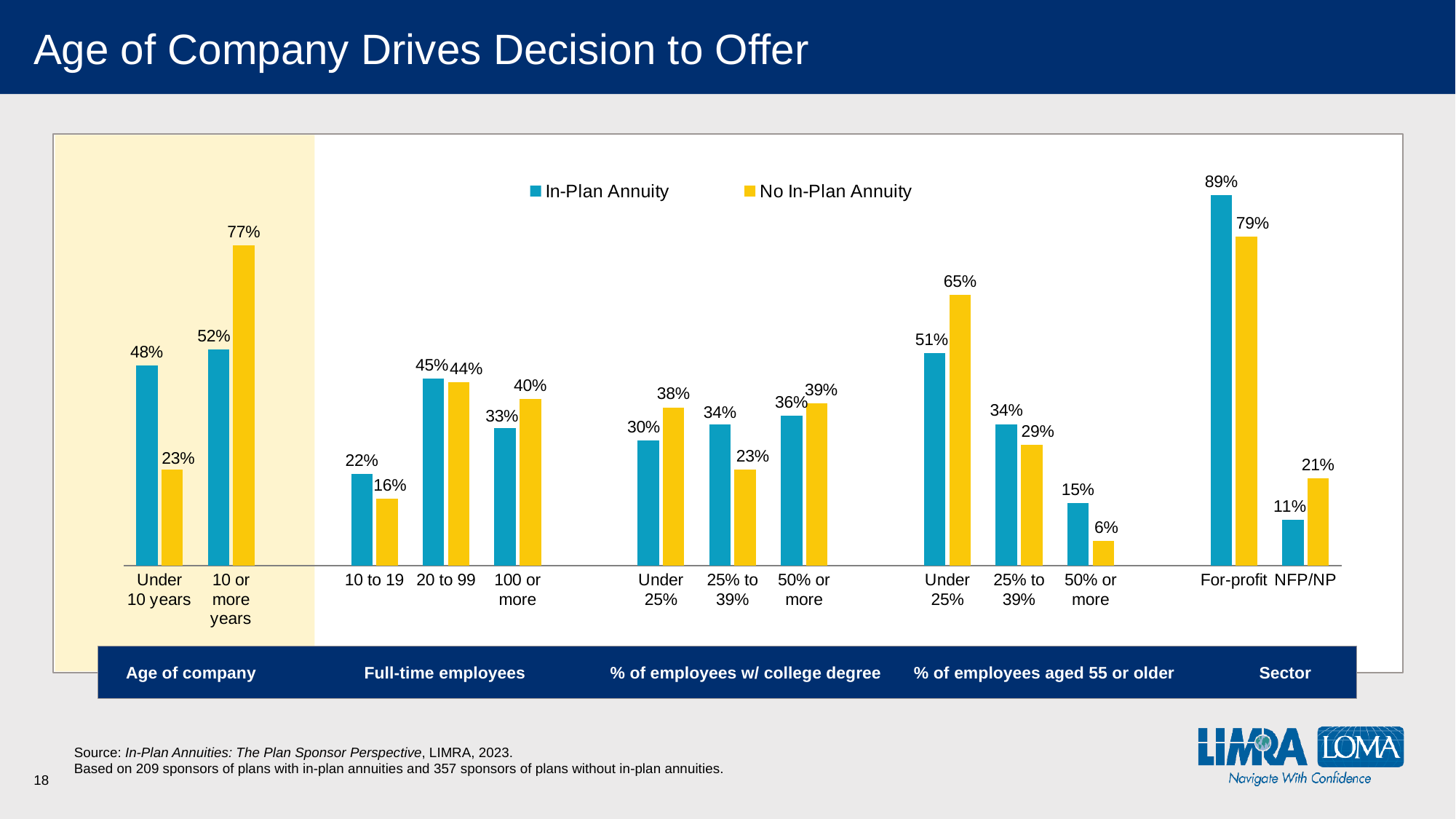
What is the No In-Plan Annuity value for the '50% or more' category under '% of employees aged 55 or older'? 6% How many series does the legend list? 2 For the '10 to 19' full-time employees category, which series has the larger value, In-Plan Annuity or No In-Plan Annuity? In-Plan Annuity What is the In-Plan Annuity value for companies aged 10 or more years? 52% What kind of chart is shown on the slide? Bar chart What is the No In-Plan Annuity value for companies under 10 years old? 23% Which category has the lowest In-Plan Annuity value? NFP/NP Which category has the highest No In-Plan Annuity value? For-profit Which colour represents the No In-Plan Annuity series? Yellow What is the In-Plan Annuity value for the For-profit sector? 89% What is the difference between the In-Plan Annuity and No In-Plan Annuity values for the For-profit sector? 10% What is the difference between the No In-Plan Annuity and In-Plan Annuity values for companies aged 10 or more years? 25%